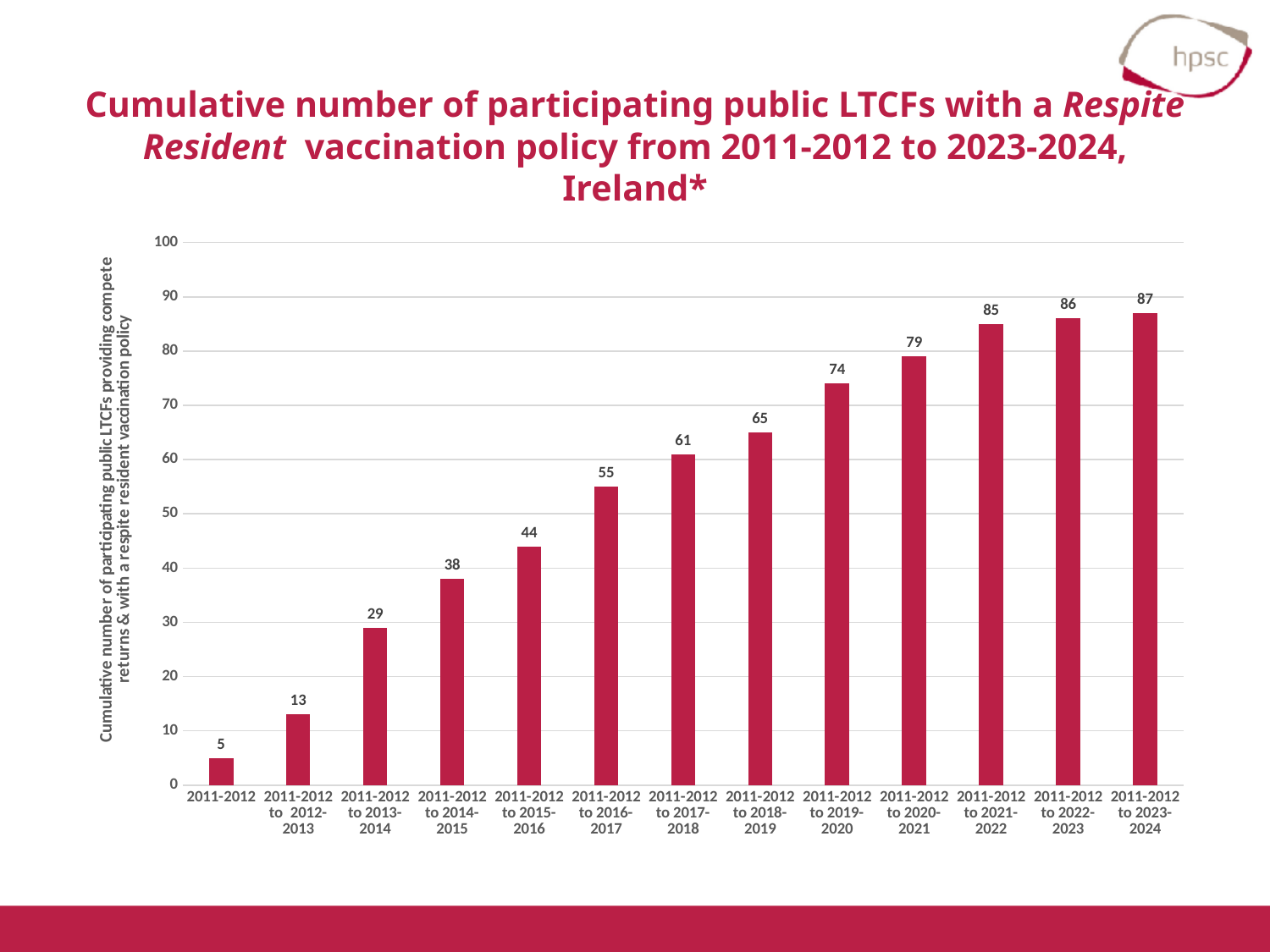
What is the difference between the values for 2011-2012 to 2019-2020 and 2011-2012 to 2018-2019? 9 Which is larger, the value for 2011-2012 to 2013-2014 or the value for 2011-2012 to 2014-2015? 2011-2012 to 2014-2015 What is the maximum value shown on the vertical axis? 100 Which period has the highest cumulative number of participating public LTCFs? 2011-2012 to 2023-2024 What is the value shown for the 2011-2012 bar? 5 How many bars are plotted on the chart? 13 Which period has the lowest value on the chart? 2011-2012 Is the value for 2011-2012 to 2017-2018 greater or less than 70? less What is the cumulative number of public LTCFs with a respite resident vaccination policy for 2011-2012 to 2016-2017? 55 What is the value for 2011-2012 to 2020-2021? 79 Do the values rise or fall from left to right along the x axis? Rise What kind of chart is shown on the slide? Bar chart